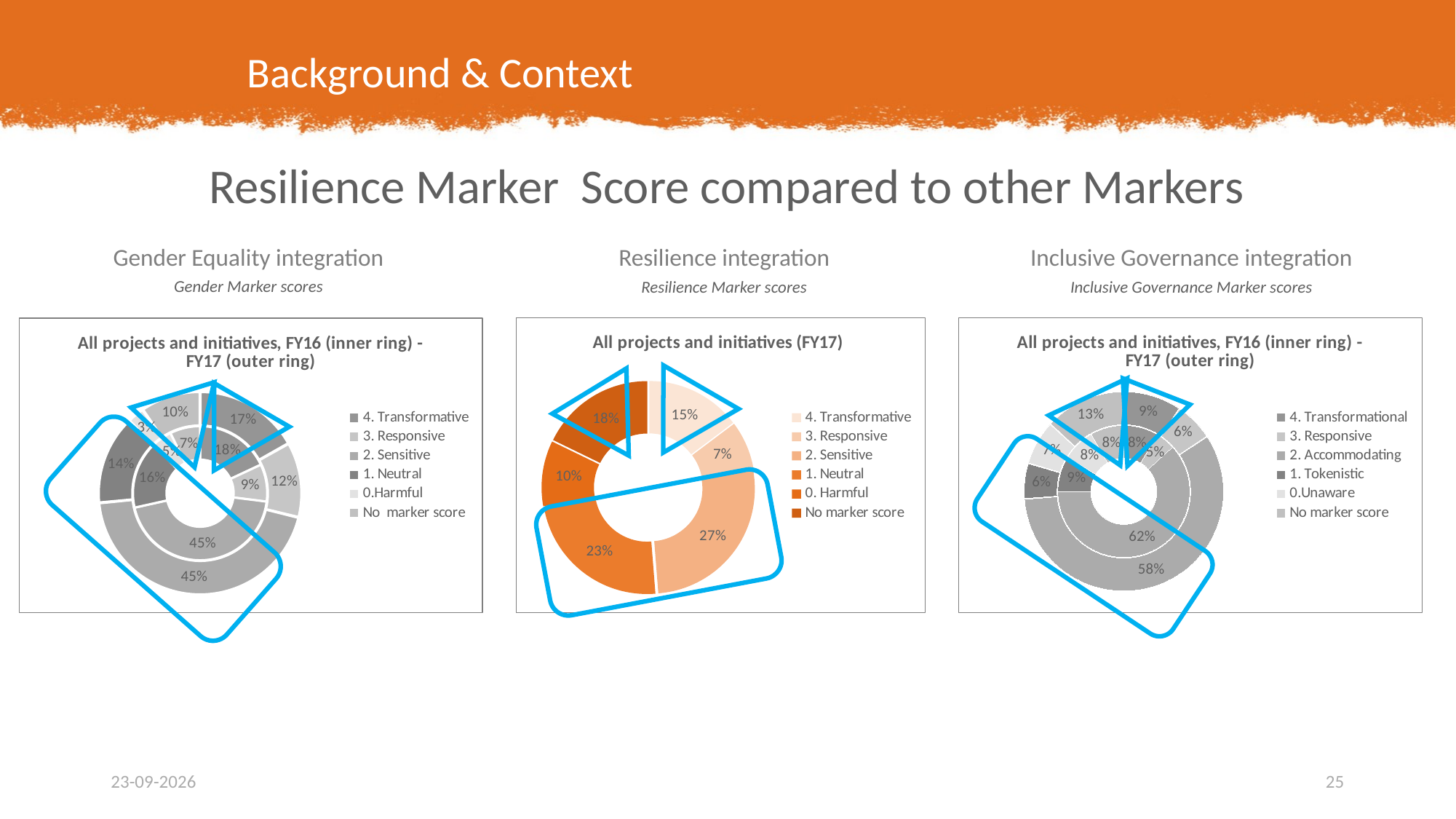
In the Gender Marker scores chart, what is the largest percentage shown on the outer (FY17) ring? 45% In the Gender Marker scores chart, which ring represents FY16? inner ring In the Inclusive Governance Marker scores chart, what is the largest percentage shown on the inner (FY16) ring? 62% In the Resilience Marker scores chart, what share is labelled for 4. Transformative? 15% In the Resilience Marker scores chart, what share is labelled for No marker score? 18% In the Resilience Marker scores chart, which category has the largest share? 2. Sensitive In the Resilience Marker scores chart, what is the difference between the shares for 2. Sensitive and 1. Neutral? 4% How many categories does the legend of the Resilience Marker scores chart list? 6 What kind of chart is the Resilience Marker scores chart? doughnut (pie) chart In the Resilience Marker scores chart, what share is labelled for 2. Sensitive? 27% In the Resilience Marker scores chart, which category has the smallest share? 3. Responsive